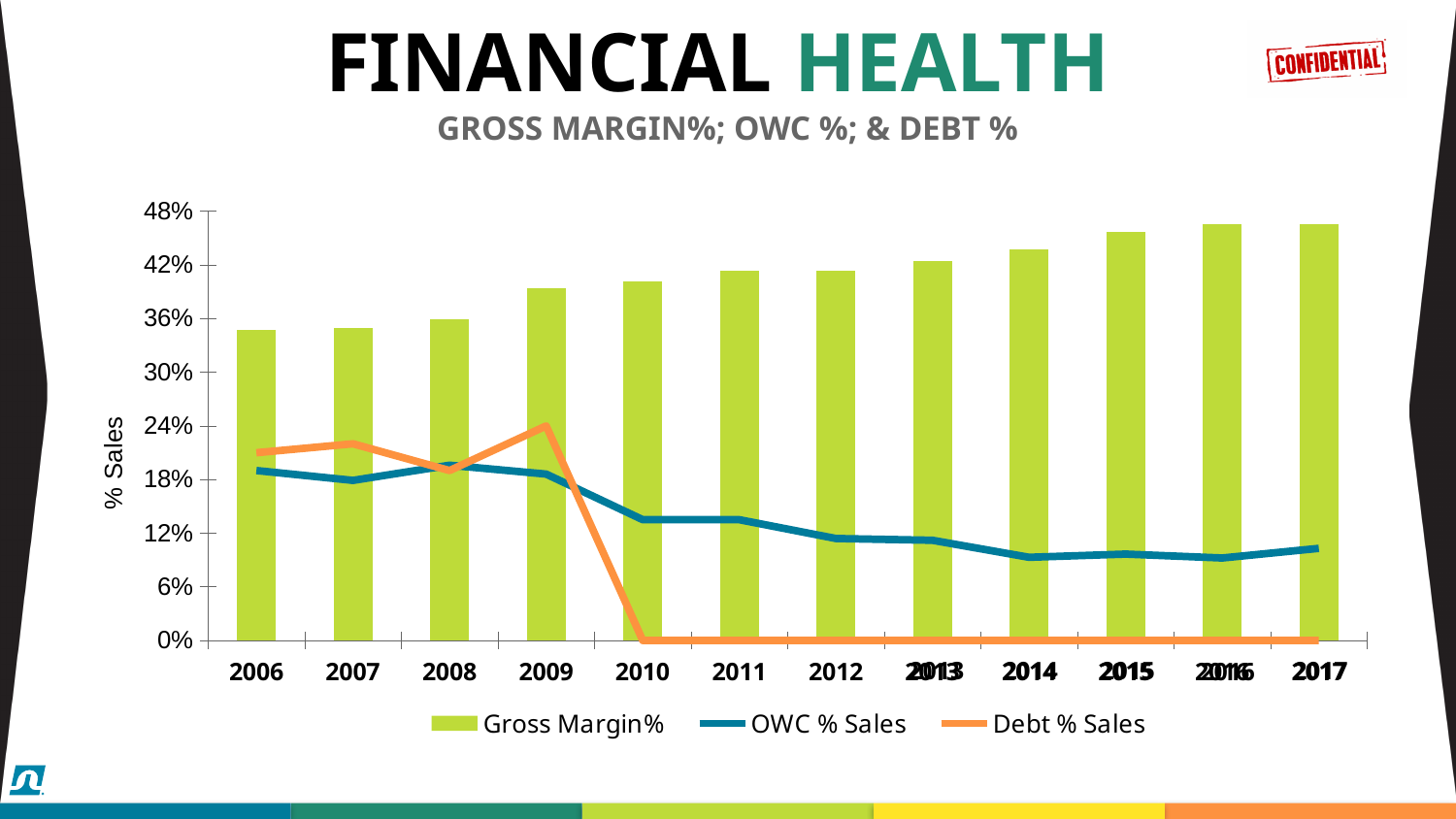
What is the Debt % Sales value for 2017? 0% Is the Gross Margin% value for 2006 greater or less than 36%? less Is the Debt % Sales value for 2007 greater or less than 18%? greater Which is larger in 2009, OWC % Sales or Debt % Sales? Debt % Sales Which series is plotted as bars in the chart? Gross Margin% How many years are shown on the x axis of the chart? 12 Is the Gross Margin% value for 2017 greater or less than 42%? greater What kind of chart is shown on the slide? Combined bar and line chart Does Gross Margin% generally rise or fall from 2006 to 2017? rise How many series does the chart legend list? 3 What is the Debt % Sales value for 2012? 0%